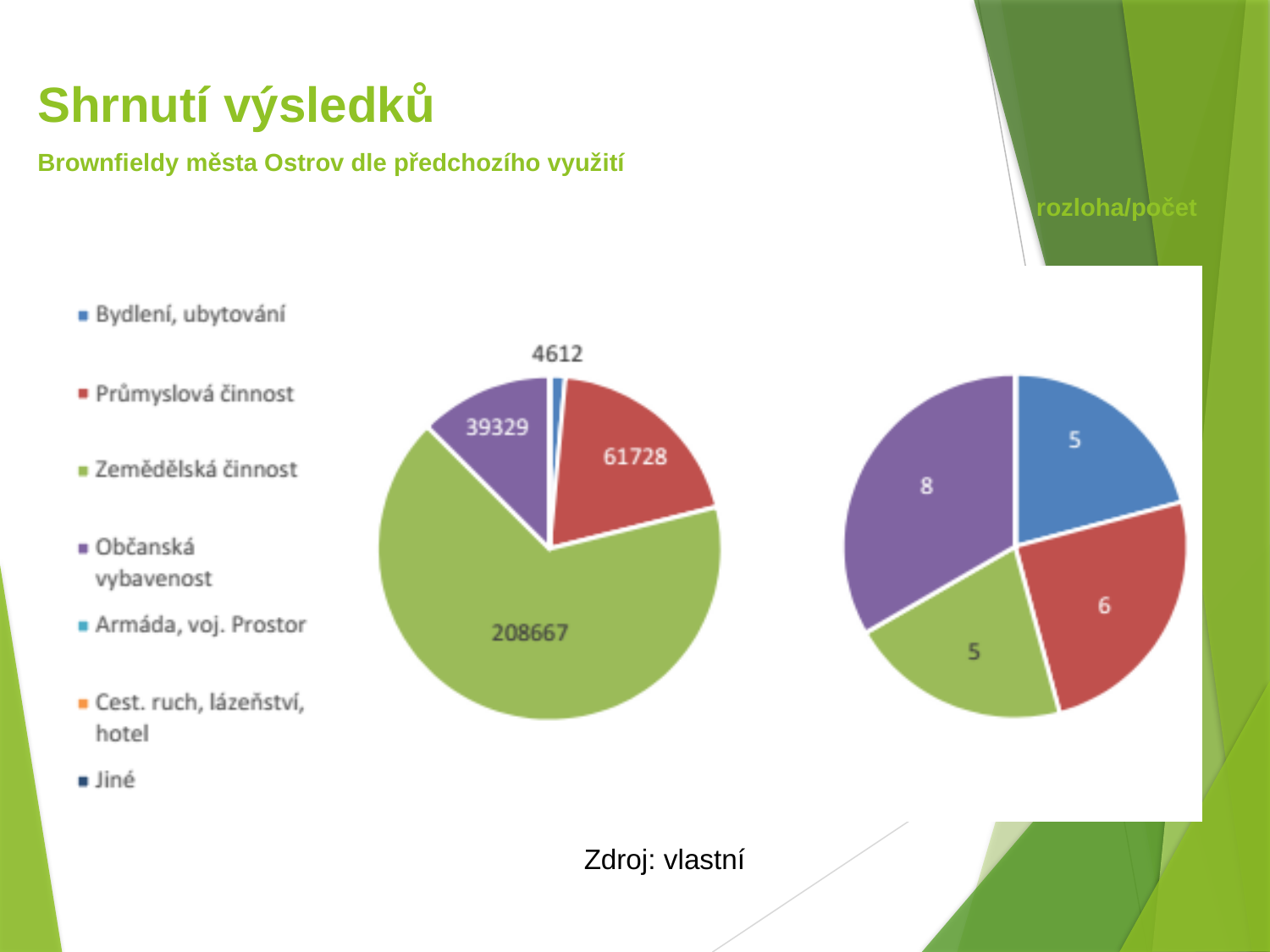
In the left pie chart, which is larger: the value for Občanská vybavenost or the value for Průmyslová činnost? Průmyslová činnost In the left pie chart, what is the difference between the values for Zemědělská činnost and Průmyslová činnost? 146939 In the left pie chart, which category has the largest slice? Zemědělská činnost In the right pie chart, what value is shown for Průmyslová činnost? 6 In the left pie chart, which category has the smallest slice? Bydlení, ubytování What type of chart is used on this slide? Pie chart In the right pie chart, what is the difference between the values for Občanská vybavenost and Bydlení, ubytování? 3 In the left pie chart, what value is shown for Bydlení, ubytování? 4612 In the left pie chart, what value is shown for Průmyslová činnost? 61728 In the right pie chart, which category has the largest slice? Občanská vybavenost In the left pie chart, what value is shown for Zemědělská činnost? 208667 In the right pie chart, what value is shown for Občanská vybavenost? 8